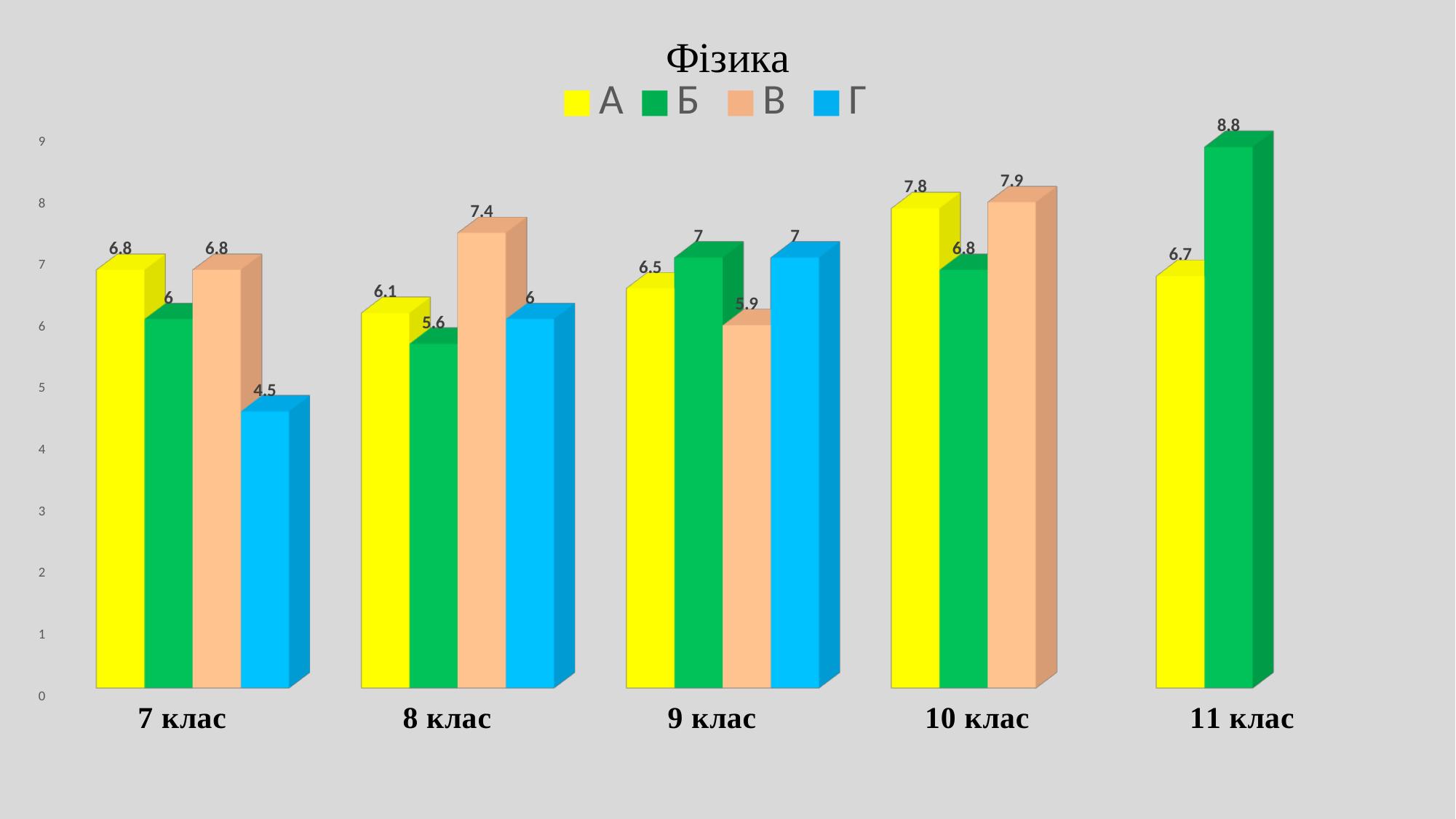
Which category has the highest value for series Б? 11 клас What is the value for series Б in 7 клас? 6 What is the title of the chart? Фізика How many categories are shown on the x axis? 5 Which is larger in 8 клас: series А or series Б? А What is the difference between series Б and series А in 11 клас? 2.1 What is the value for series А in 10 клас? 7.8 Which category has the lowest value for series Г? 7 клас How many series does the legend list? 4 What is the value for series Г in 9 клас? 7 What is the value for series В in 8 клас? 7.4 What kind of chart is shown? bar chart